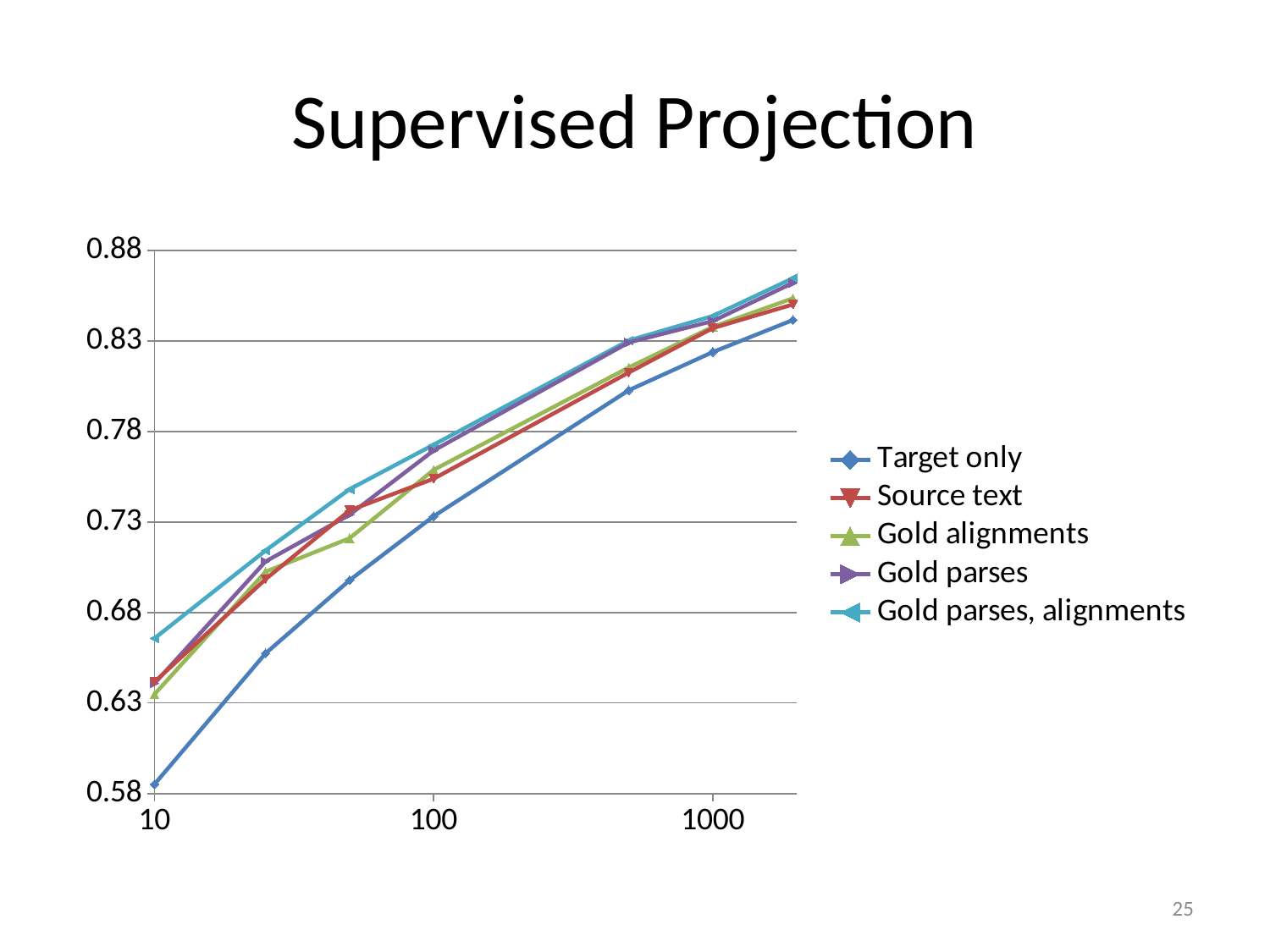
Is the value for Target only at x = 100 greater or less than 0.78? less What kind of chart is shown on the slide? line chart How many series does the legend list? 5 What is the title of the chart? Supervised Projection Which series has the lowest value at x = 10? Target only Is the value for Target only at x = 10 greater or less than 0.63? less Which series has the lowest value at x = 100? Target only Do the values for the Target only series rise or fall as the x axis increases? rise Which series has the highest value at x = 10? Gold parses, alignments At x = 10, which is larger: the value for Target only or the value for Gold parses, alignments? Gold parses, alignments Is the value for Gold parses, alignments at x = 10 greater or less than 0.63? greater Which series is listed last in the legend? Gold parses, alignments